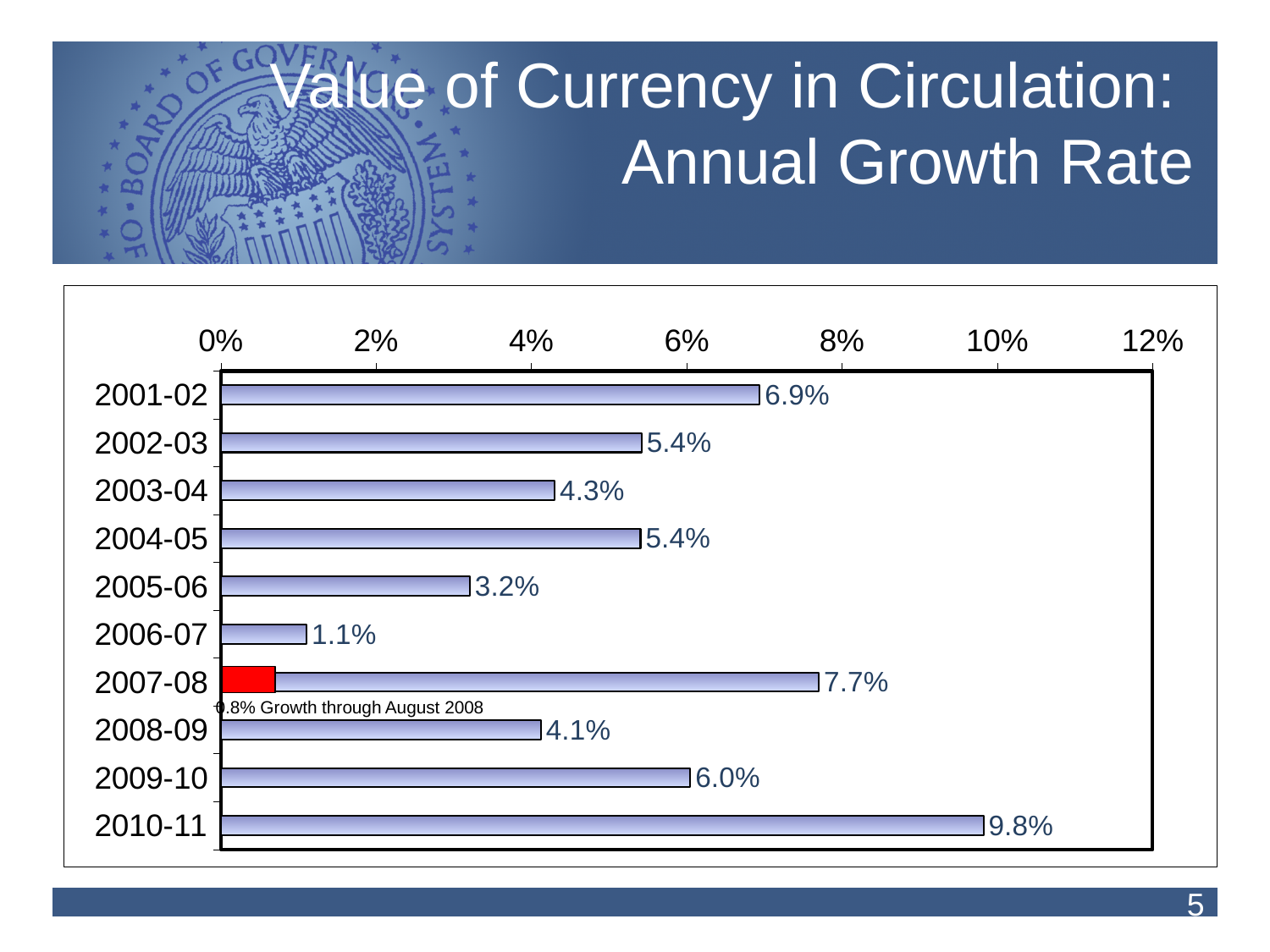
What does the red bar in the 2007-08 row represent? 0.8% Growth through August 2008 What kind of chart is shown on the slide? bar chart What is the difference between the growth rates for 2010-11 and 2009-10? 3.8% How many periods are shown on the chart? 10 What is the annual growth rate for 2010-11? 9.8% What is the annual growth rate for 2007-08? 7.7% What is the annual growth rate for 2006-07? 1.1% What is the highest value shown on the horizontal axis? 12% Which is larger, the growth rate for 2001-02 or for 2008-09? 2001-02 Is the value for 2005-06 greater or less than 4%? less Which period has the lowest annual growth rate? 2006-07 Which period has the highest annual growth rate? 2010-11